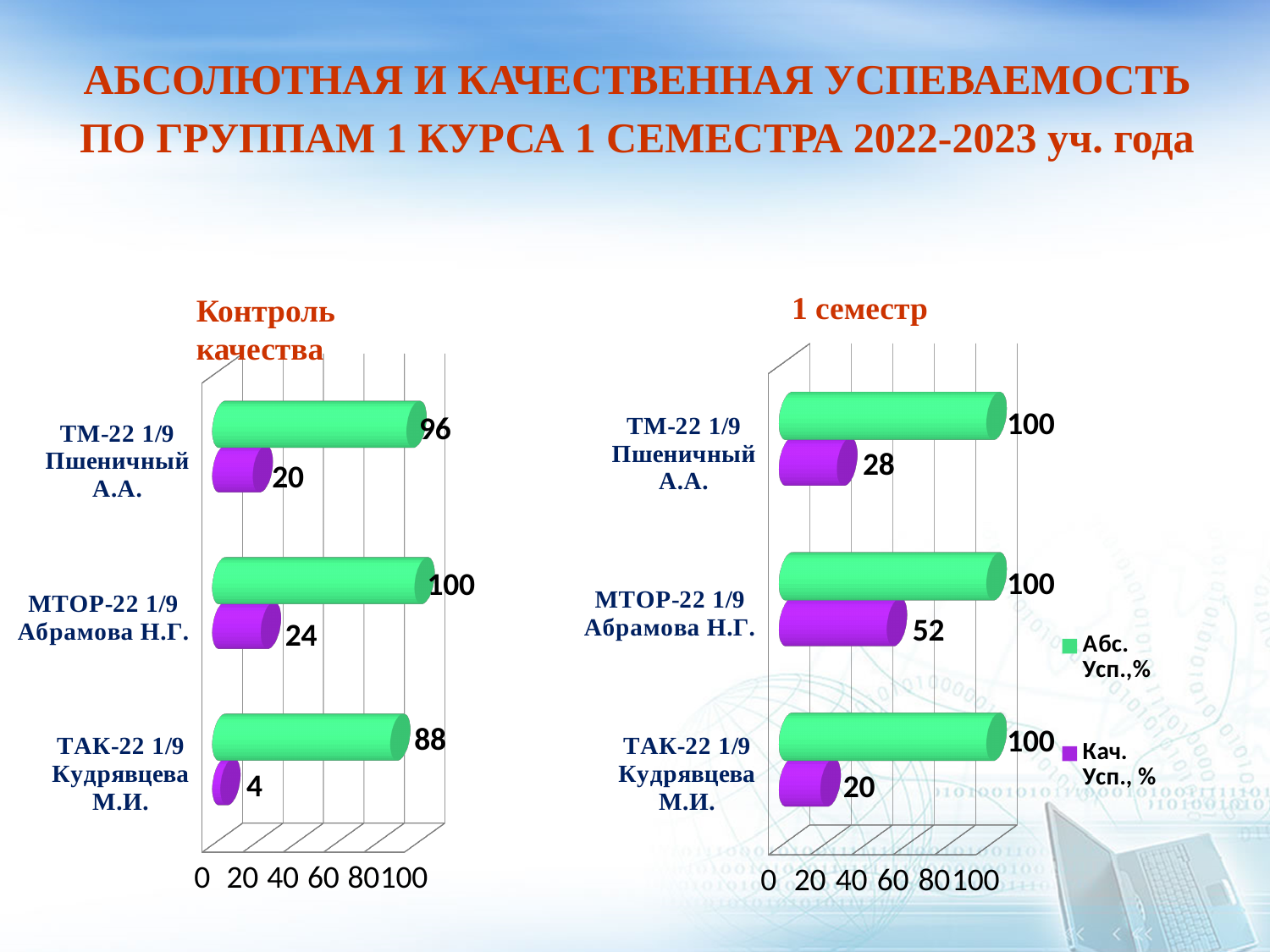
Is the Кач. Усп., % value for ТМ-22 1/9 Пшеничный А.А. larger in the 'Контроль качества' chart or in the '1 семестр' chart? 1 семестр How many groups are shown in the '1 семестр' chart? 3 How many series does the legend of the '1 семестр' chart list? 2 In the '1 семестр' chart, which group has the highest Кач. Усп., % value? МТОР-22 1/9 Абрамова Н.Г. In the '1 семестр' chart, what is the Абс. Усп.,% value for ТАК-22 1/9 Кудрявцева М.И.? 100 In the '1 семестр' chart, what is the difference between the Кач. Усп., % values for МТОР-22 1/9 Абрамова Н.Г. and ТМ-22 1/9 Пшеничный А.А.? 24 In the 'Контроль качества' chart, what is the Кач. Усп., % value for ТАК-22 1/9 Кудрявцева М.И.? 4 In the 'Контроль качества' chart, what is the difference between the Абс. Усп.,% and Кач. Усп., % values for МТОР-22 1/9 Абрамова Н.Г.? 76 What type of chart is the 'Контроль качества' chart? Bar chart In the 'Контроль качества' chart, what is the Абс. Усп.,% value for ТМ-22 1/9 Пшеничный А.А.? 96 In the '1 семестр' chart, what is the Кач. Усп., % value for МТОР-22 1/9 Абрамова Н.Г.? 52 In the 'Контроль качества' chart, which group has the lowest Абс. Усп.,% value? ТАК-22 1/9 Кудрявцева М.И.